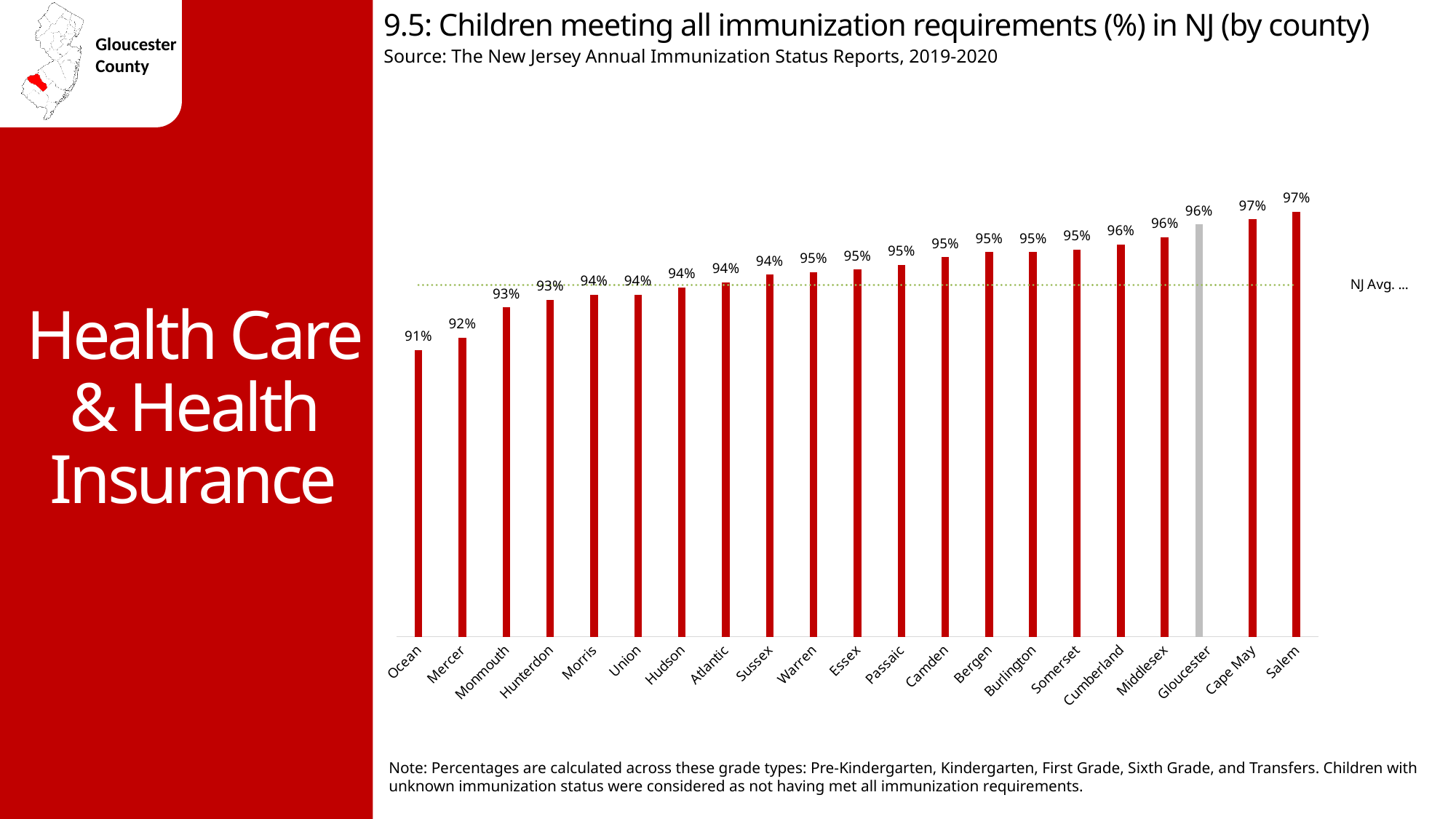
What is the difference in percentage points between Salem and Ocean? 6 percentage points What is the difference in percentage points between Gloucester and Mercer? 4 percentage points What kind of chart is shown on the slide? Bar chart Which has a higher value, Monmouth or Cumberland? Cumberland What percentage of children in Gloucester County met all immunization requirements? 96% Do the values rise or fall moving from left to right along the x axis? Rise What is the value shown for Ocean County? 91% What is the value for Cape May County? 97% How many counties are shown on the chart? 21 Which two counties share the highest value on the chart? Cape May and Salem Which county has the lowest percentage of children meeting all immunization requirements? Ocean What percentage is shown for Hunterdon County? 93%